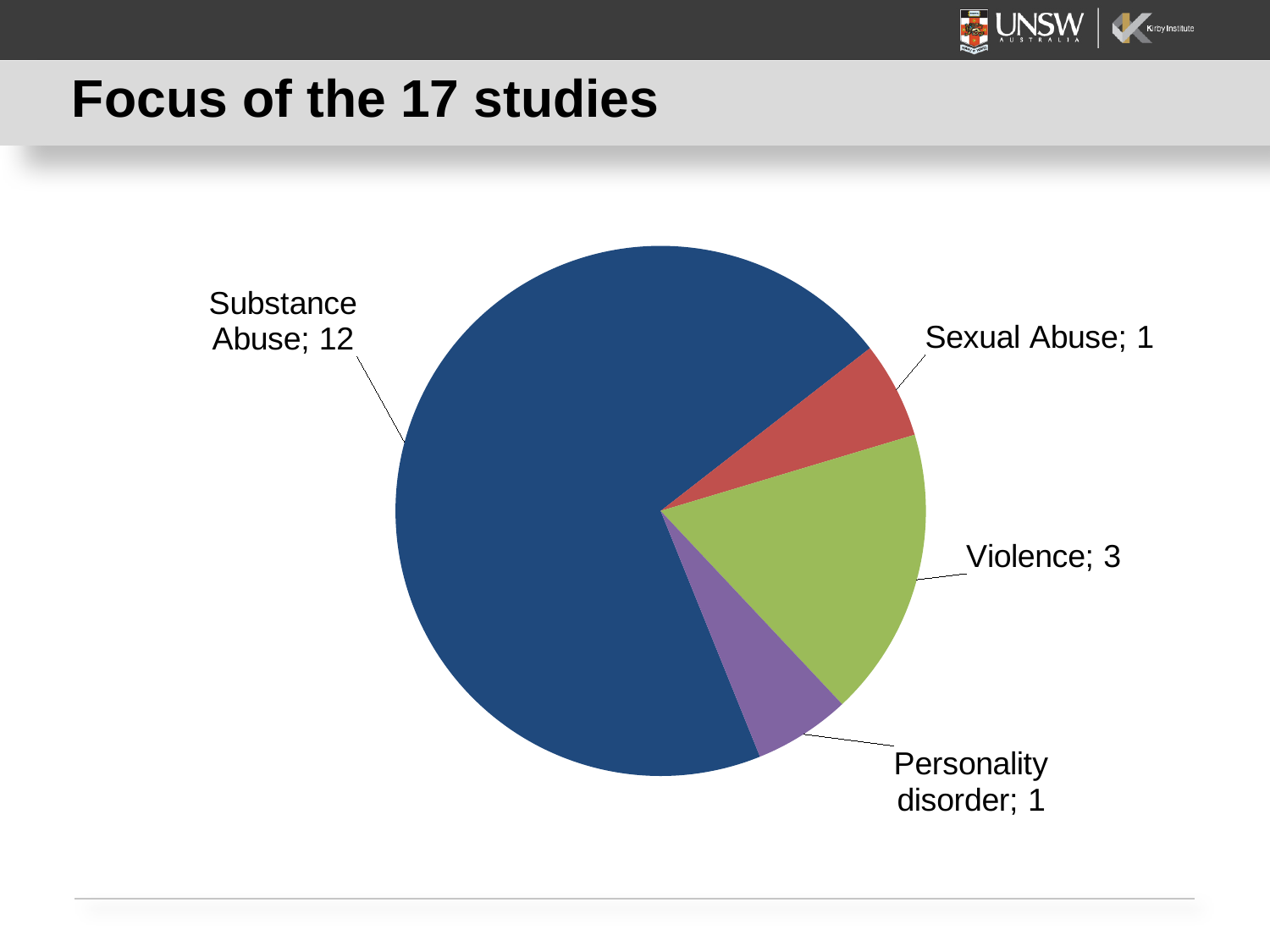
What fraction of the 17 studies focus on Substance Abuse? 12/17 Which two categories have the smallest value in the pie chart? Sexual Abuse and Personality disorder What is the difference between the number of Substance Abuse studies and Violence studies? 9 What is the title of the chart on the slide? Focus of the 17 studies How many studies focus on Sexual Abuse? 1 Which category has the largest slice of the pie? Substance Abuse How many categories are shown in the pie chart? 4 Which has more studies, Violence or Sexual Abuse? Violence How many studies focus on Substance Abuse? 12 What kind of chart is shown on the slide? Pie chart How many studies focus on Personality disorder? 1 How many studies focus on Violence? 3